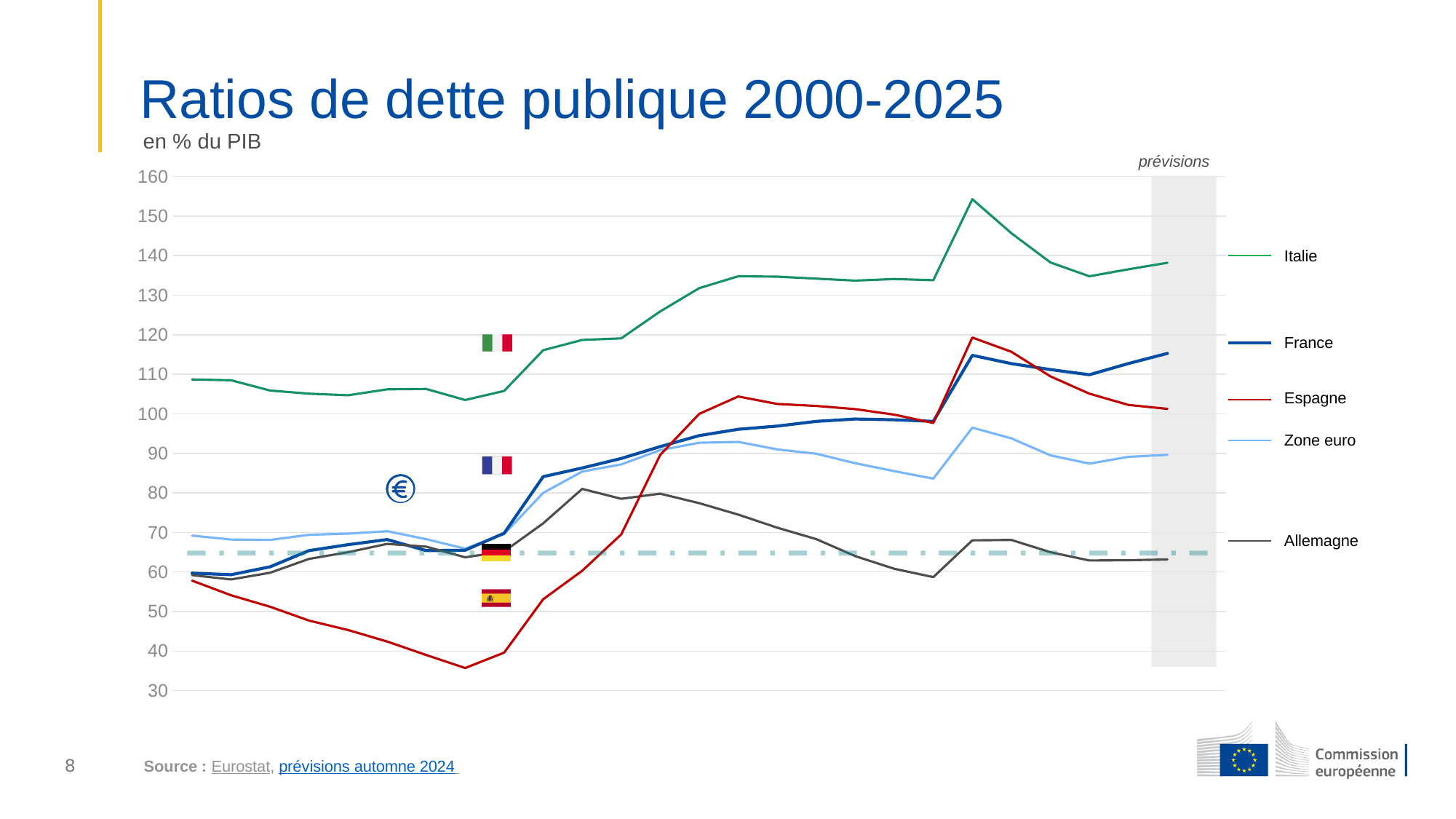
What is the title of the chart? Ratios de dette publique 2000-2025 Is the value for France at the right end of the chart greater or less than 110? greater Overall from left to right, does the Espagne line rise or fall? rise Is the peak value for Italie greater or less than 150? greater Which series has the highest value at the right end of the chart? Italie At the right end of the chart, which is larger, France or Espagne? France What kind of chart is shown on the slide? line chart What label is written above the shaded area at the right of the chart? prévisions Which series has the lowest value at the right end of the chart? Allemagne Is the lowest value for Espagne greater or less than 40? less How many series does the legend list? 5